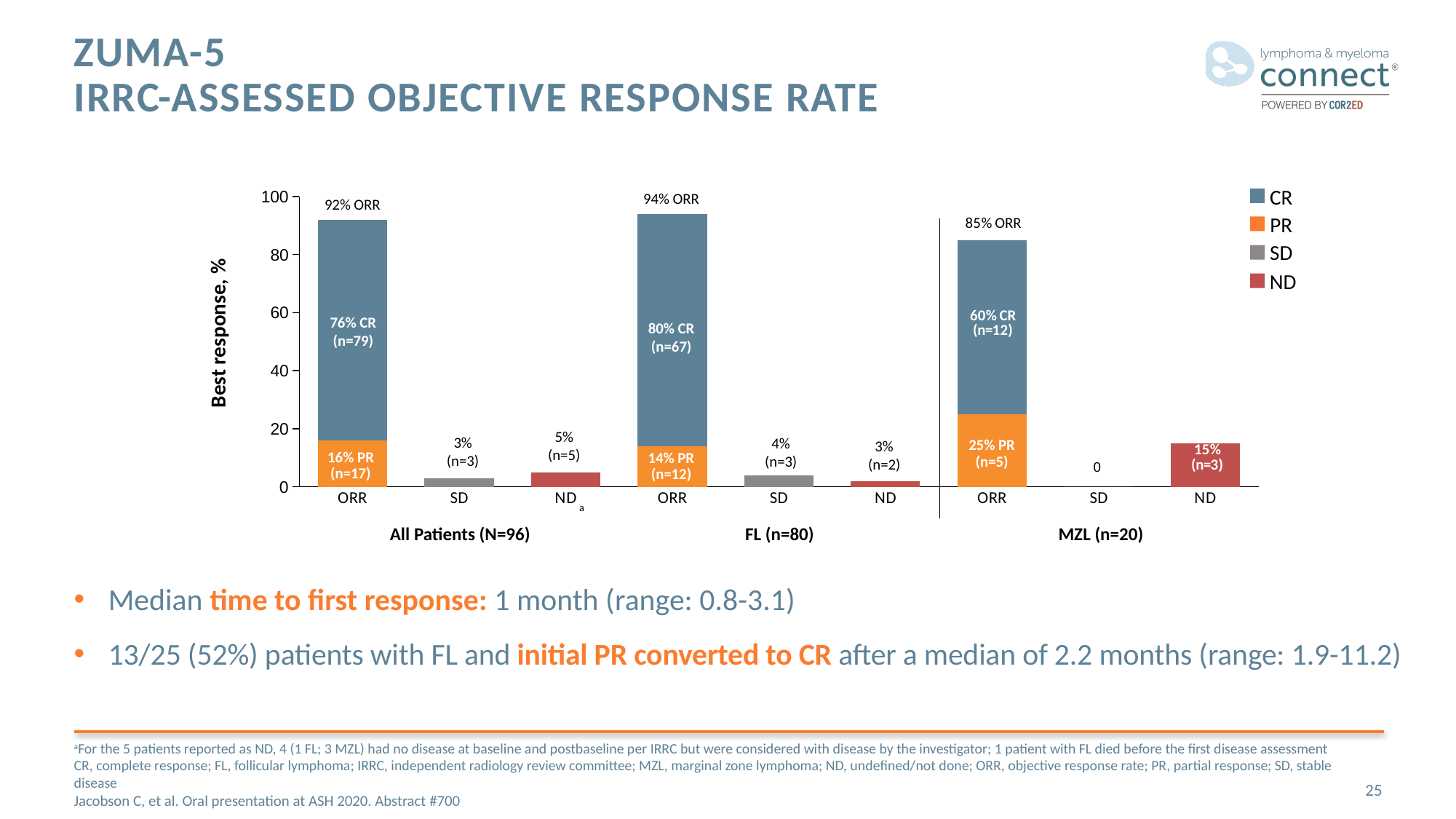
How many series does the legend list? 4 What is the CR rate in the FL (n=80) group? 80% CR (n=67) Which is larger, the CR rate for All Patients (N=96) or the CR rate for MZL (n=20)? All Patients (N=96) What is the PR rate in the MZL (n=20) group? 25% PR (n=5) What is the ORR for All Patients (N=96)? 92% ORR What is the difference between the ORR for FL (n=80) and the ORR for MZL (n=20)? 9% What is the ND value for the MZL (n=20) group? 15% (n=3) What kind of chart is shown on the slide? Stacked bar chart Which patient group has the highest ORR? FL (n=80) What is the label on the y axis of the chart? Best response, % Is the ORR bar for MZL (n=20) greater or less than 80? greater Which patient group has the lowest ORR? MZL (n=20)